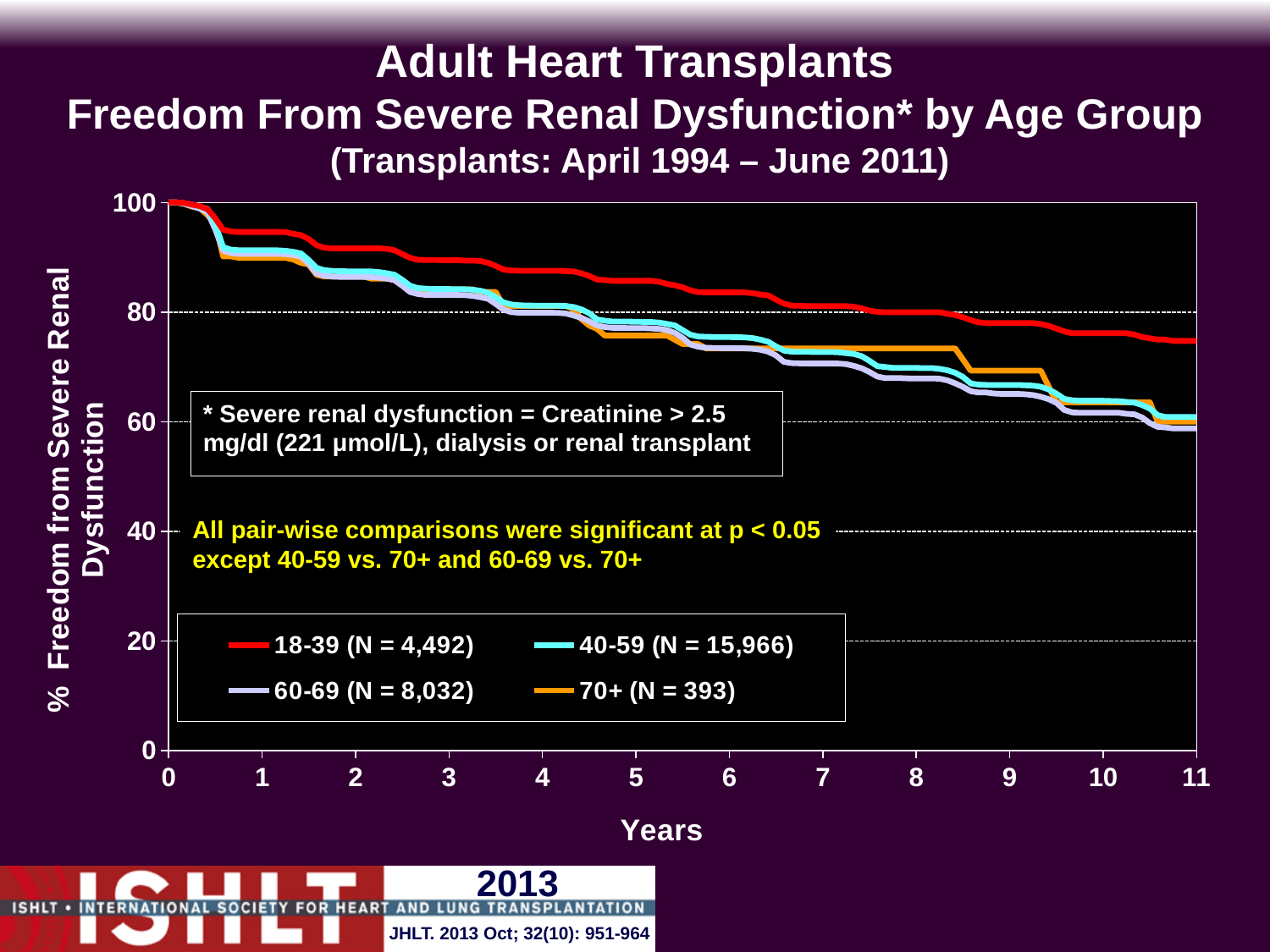
What is the maximum value shown on the x axis (Years)? 11 Which age group has the highest freedom from severe renal dysfunction at 11 years? 18-39 What kind of chart is shown on the slide? Line chart Does the freedom from severe renal dysfunction for the 18-39 group rise or fall as years increase? Fall How many age-group series does the legend list? 4 According to the legend, what is N for the 40-59 age group? 15,966 At 8 years, which group has the higher value: 18-39 or 60-69? 18-39 Is the value for the 18-39 group at 11 years greater or less than 80? less Is the value for the 60-69 group at 11 years greater or less than 40? greater Is the value for the 60-69 group at 5 years greater or less than 80? less